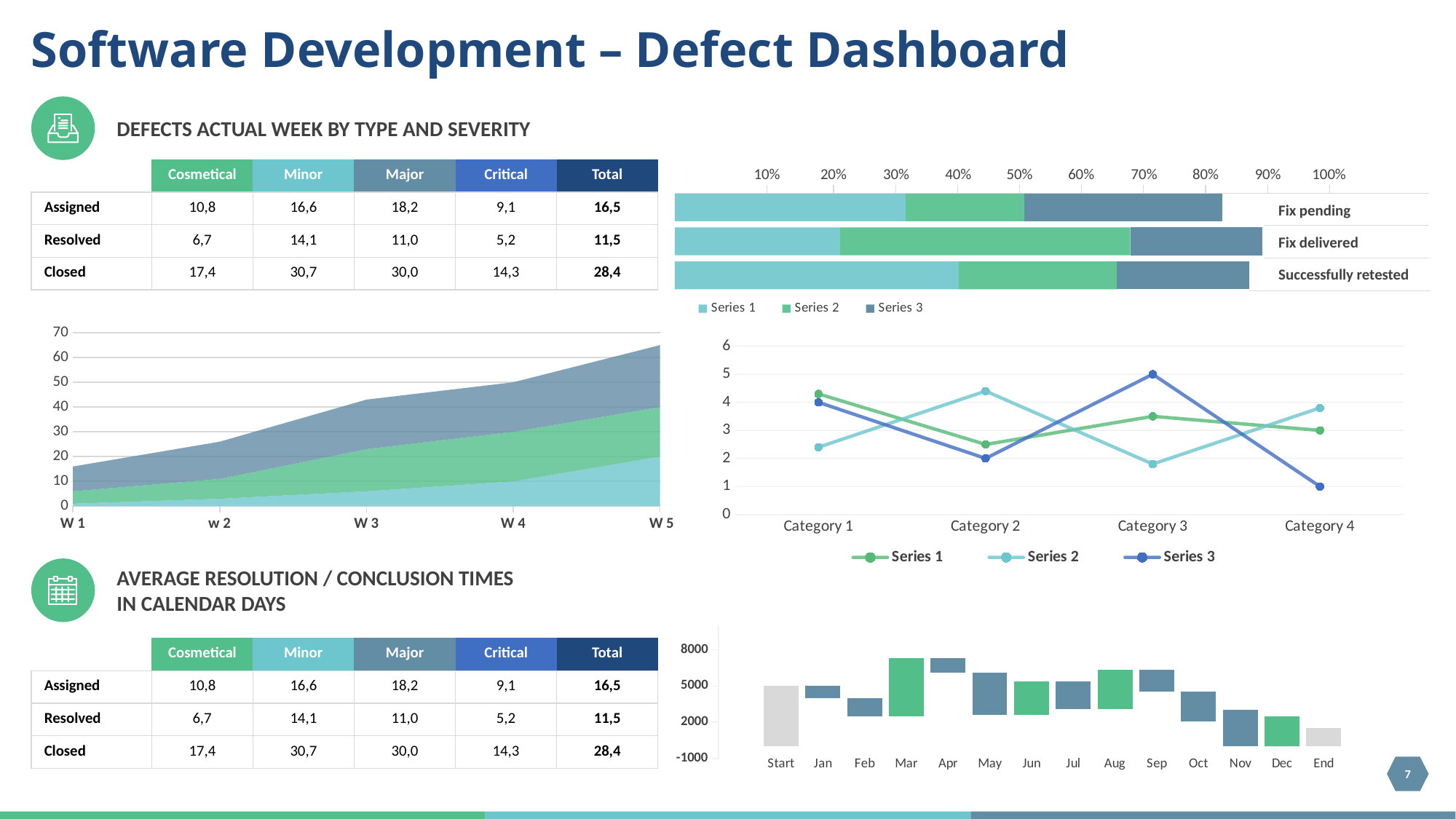
In the line chart with Category 1 to Category 4, at which category is Series 3 highest? Category 3 In the area chart with W 1 to W 5, is the top of the stacked area at W 5 greater or less than 60? greater In the bar chart at the bottom right with months from Start to End, is the value of the Start bar greater or less than 2000? greater In the line chart with Category 1 to Category 4, how many categories are shown on the x axis? 4 How many series does the legend of the line chart with Category 1 to Category 4 list? 3 In the line chart with Category 1 to Category 4, what is the value of Series 3 at Category 4? 1 In the line chart with Category 1 to Category 4, which series has the lowest value at Category 4? Series 3 In the stacked bar chart with Fix pending, Fix delivered and Successfully retested, how many categories are shown? 3 In the area chart with W 1 to W 5, does the top of the stacked area rise or fall from W 1 to W 5? rise What kind of chart is the chart at the bottom right of the slide with months from Start to End? bar chart In the line chart with Category 1 to Category 4, what is the value of Series 3 at Category 3? 5 In the area chart with W 1 to W 5, is the top of the stacked area at W 1 greater or less than 20? less